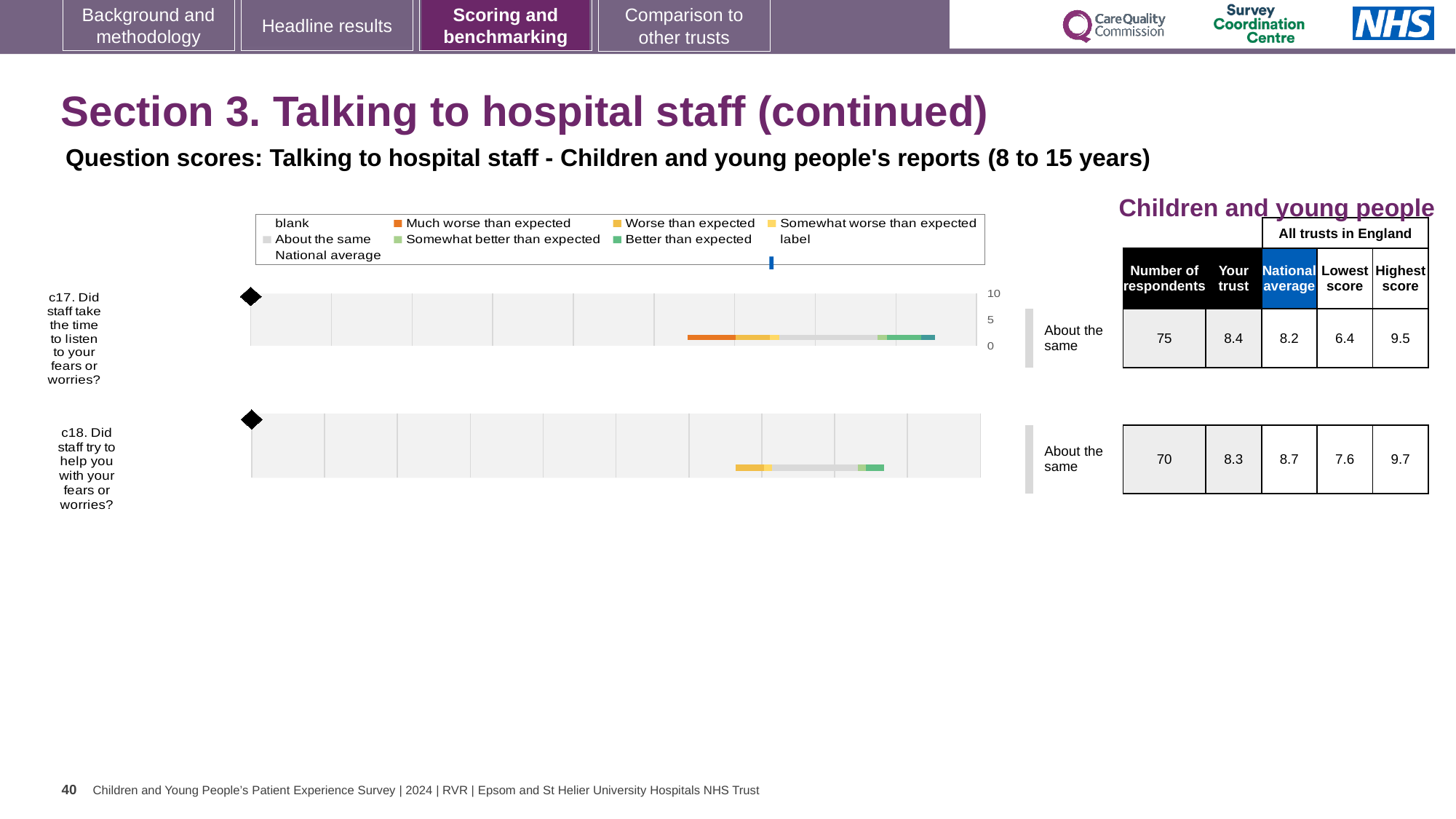
Which question has the higher 'Your trust' score, c17 or c18? c17 What kind of chart is used to show the c17 and c18 question scores? bar chart What is the 'Your trust' score for c17? 8.4 What is the lowest score across all trusts in England for c17? 6.4 Which benchmarking category is shown for c17 (Did staff take the time to listen to your fears or worries)? About the same What is the national average score for c18? 8.7 How many respondents answered c17? 75 What is the difference between the highest score and the lowest score for c18? 2.1 Is the plotted score band for c17 greater or less than 5 on the axis? greater How many survey questions are plotted on the slide? 2 Which benchmarking category is shown for c18 (Did staff try to help you with your fears or worries)? About the same For c17, which is larger: the 'Your trust' score or the national average? Your trust